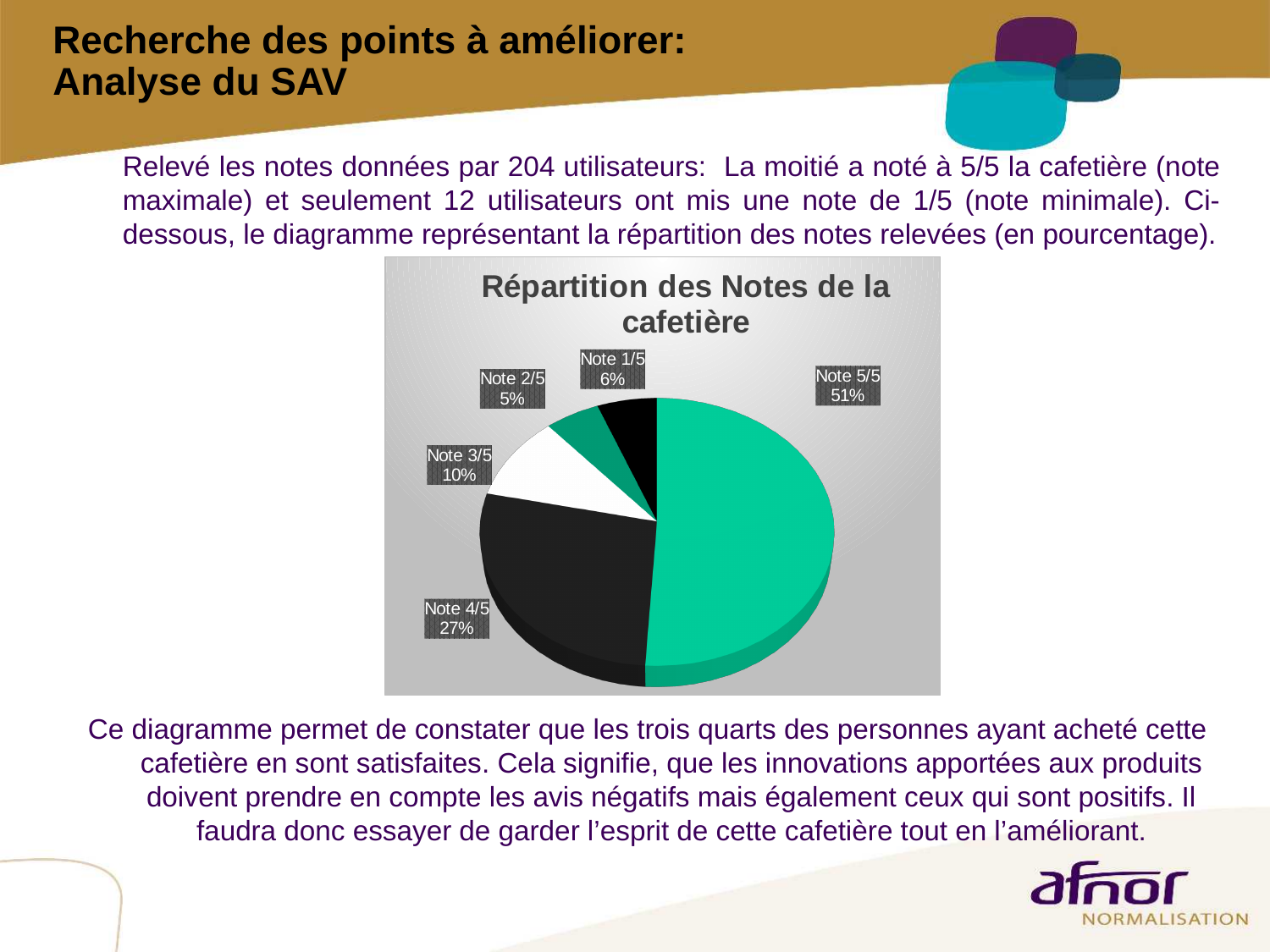
How many slices does the pie chart have? 5 What is the title of the chart? Répartition des Notes de la cafetière What percentage of the pie does Note 2/5 represent? 5% What percentage of the pie does Note 3/5 represent? 10% What is the difference in percentage points between Note 5/5 and Note 4/5? 24 What kind of chart is shown on the slide? pie chart Which note has the largest share of the pie? Note 5/5 What percentage of the pie does Note 4/5 represent? 27% What percentage of the pie does Note 1/5 represent? 6% Which note has the smallest share of the pie? Note 2/5 What percentage of the pie does Note 5/5 represent? 51% Which is larger, the share for Note 3/5 or the share for Note 1/5? Note 3/5